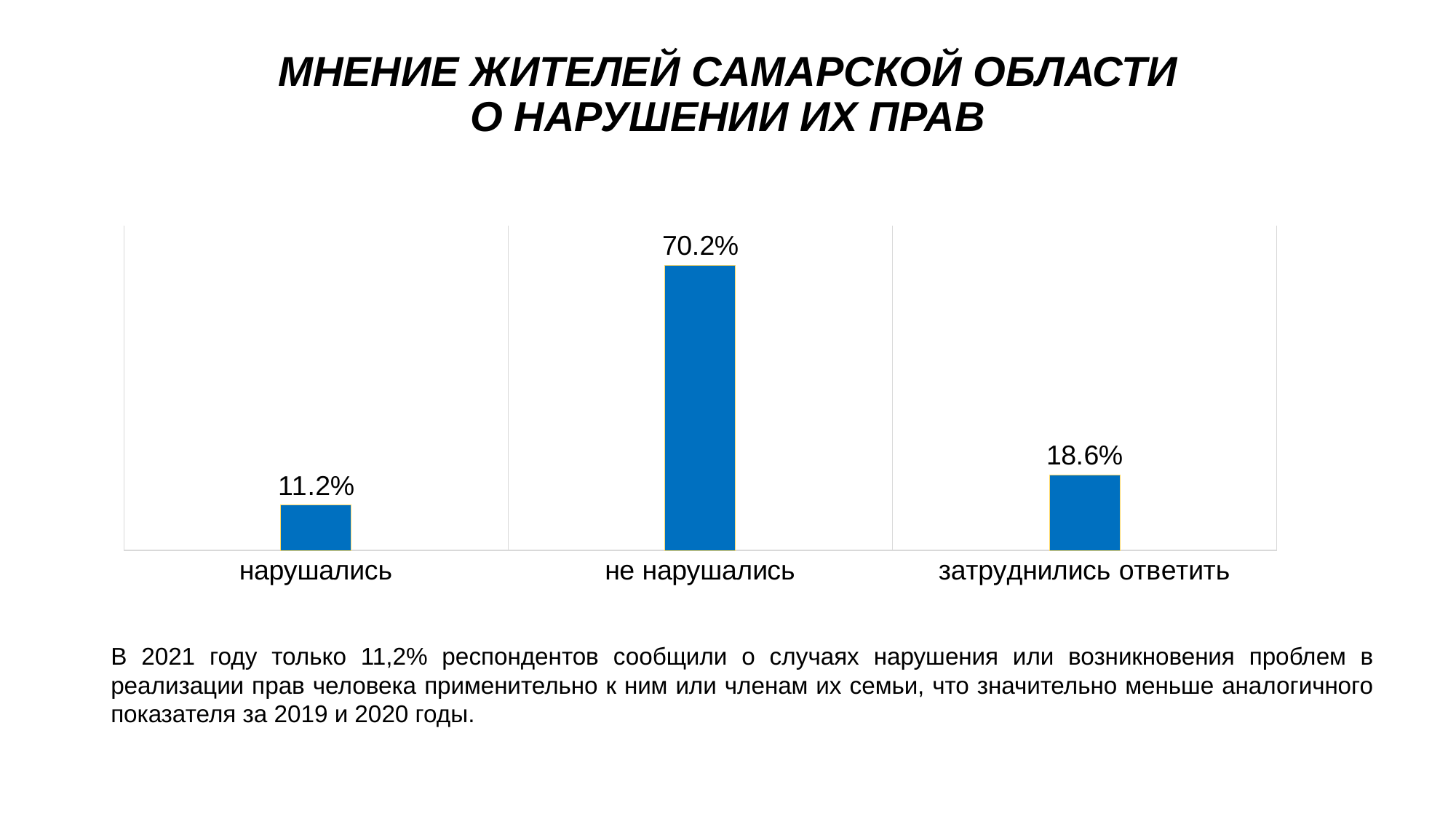
What is the total of the three values shown on the chart? 100.0% Which is larger: the value for "затруднились ответить" or the value for "нарушались"? затруднились ответить What is the difference between the values for "не нарушались" and "нарушались"? 59.0% What is the value for "не нарушались"? 70.2% What is the value for "затруднились ответить"? 18.6% Which category has the highest value? не нарушались What is the difference between the values for "затруднились ответить" and "нарушались"? 7.4% What kind of chart is shown on the slide? bar chart What colour are the bars on the chart? blue Which category has the lowest value? нарушались How many categories are shown on the chart? 3 What is the value for "нарушались"? 11.2%